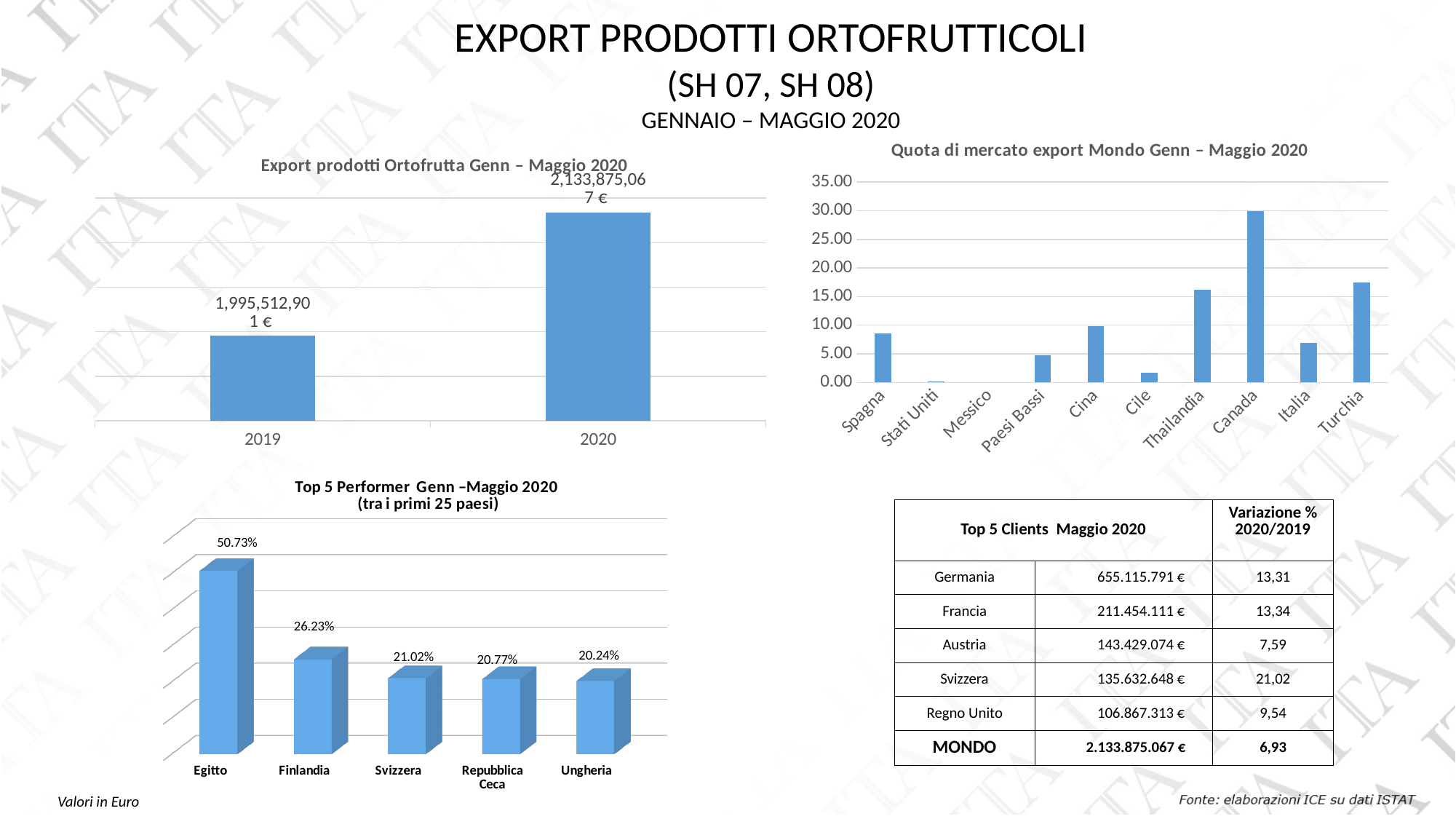
In the 'Export prodotti Ortofrutta Genn – Maggio 2020' chart, does the value rise or fall from 2019 to 2020? rise What kind of chart is the 'Quota di mercato export Mondo Genn – Maggio 2020' chart? bar chart How many countries are shown in the 'Quota di mercato export Mondo Genn – Maggio 2020' chart? 10 In the 'Quota di mercato export Mondo Genn – Maggio 2020' chart, is the value for Canada greater or less than 25.00? greater In the 'Quota di mercato export Mondo Genn – Maggio 2020' chart, which country has the highest value? Canada In the 'Top 5 Performer Genn – Maggio 2020' chart, what is the value for Egitto? 50.73% How many countries are shown in the 'Top 5 Performer Genn – Maggio 2020' chart? 5 In the 'Top 5 Performer Genn – Maggio 2020' chart, which country has the lowest value? Ungheria In the 'Quota di mercato export Mondo Genn – Maggio 2020' chart, is the value for Spagna greater or less than 10.00? less In the 'Export prodotti Ortofrutta Genn – Maggio 2020' chart, what is the value for 2019? 1,995,512,901 € In the 'Top 5 Performer Genn – Maggio 2020' chart, what is the difference between the values for Egitto and Finlandia? 24.50% In the 'Top 5 Performer Genn – Maggio 2020' chart, which country has the highest value? Egitto